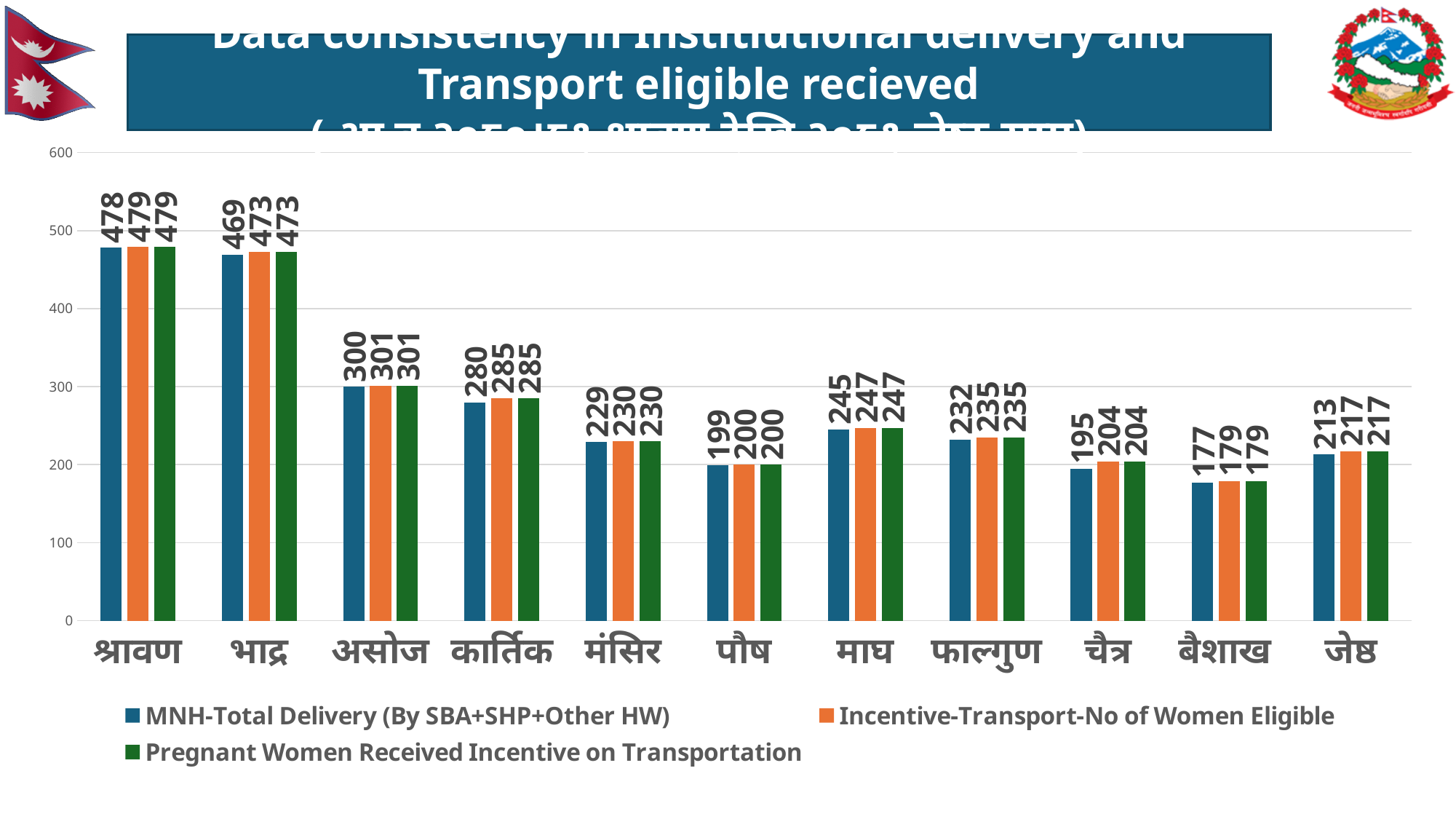
What kind of chart is shown on the slide? bar chart What is the Incentive-Transport-No of Women Eligible value for कार्तिक? 285 How many series does the legend list? 3 What is the Pregnant Women Received Incentive on Transportation value for चैत्र? 204 Is the MNH-Total Delivery value for असोज greater or less than 400? less What is the difference between the Incentive-Transport-No of Women Eligible value and the MNH-Total Delivery value for चैत्र? 9 Which month has the highest MNH-Total Delivery (By SBA+SHP+Other HW) value? श्रावण Which month has the lowest Pregnant Women Received Incentive on Transportation value? बैशाख What is the MNH-Total Delivery (By SBA+SHP+Other HW) value for श्रावण? 478 What colour are the bars for Pregnant Women Received Incentive on Transportation? green How many months are shown on the x axis? 11 Which is larger: the MNH-Total Delivery value for माघ or for फाल्गुण? माघ